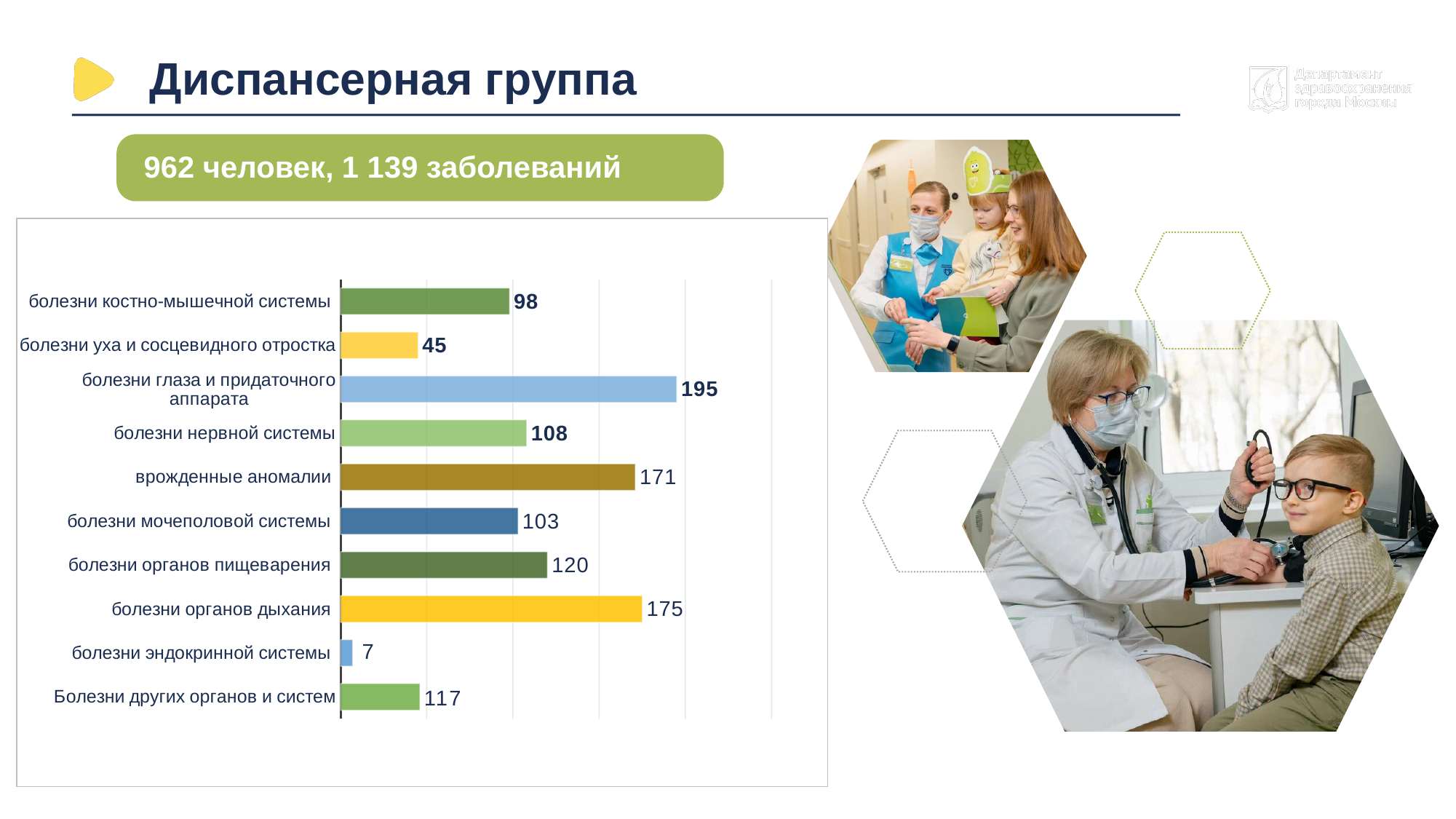
What kind of chart is shown on the slide? bar chart What is the value for болезни эндокринной системы? 7 What is the value for болезни органов дыхания? 175 What is the value for болезни глаза и придаточного аппарата? 195 What is the difference between the values for болезни костно-мышечной системы and болезни уха и сосцевидного отростка? 53 What is the value for врожденные аномалии? 171 Which category has the highest value? болезни глаза и придаточного аппарата What is the title of the slide? Диспансерная группа Which category has the lowest value? болезни эндокринной системы What is the difference between the values for болезни органов дыхания and болезни органов пищеварения? 55 How many categories are shown in the chart? 10 Which is larger: the value for болезни нервной системы or the value for болезни мочеполовой системы? болезни нервной системы